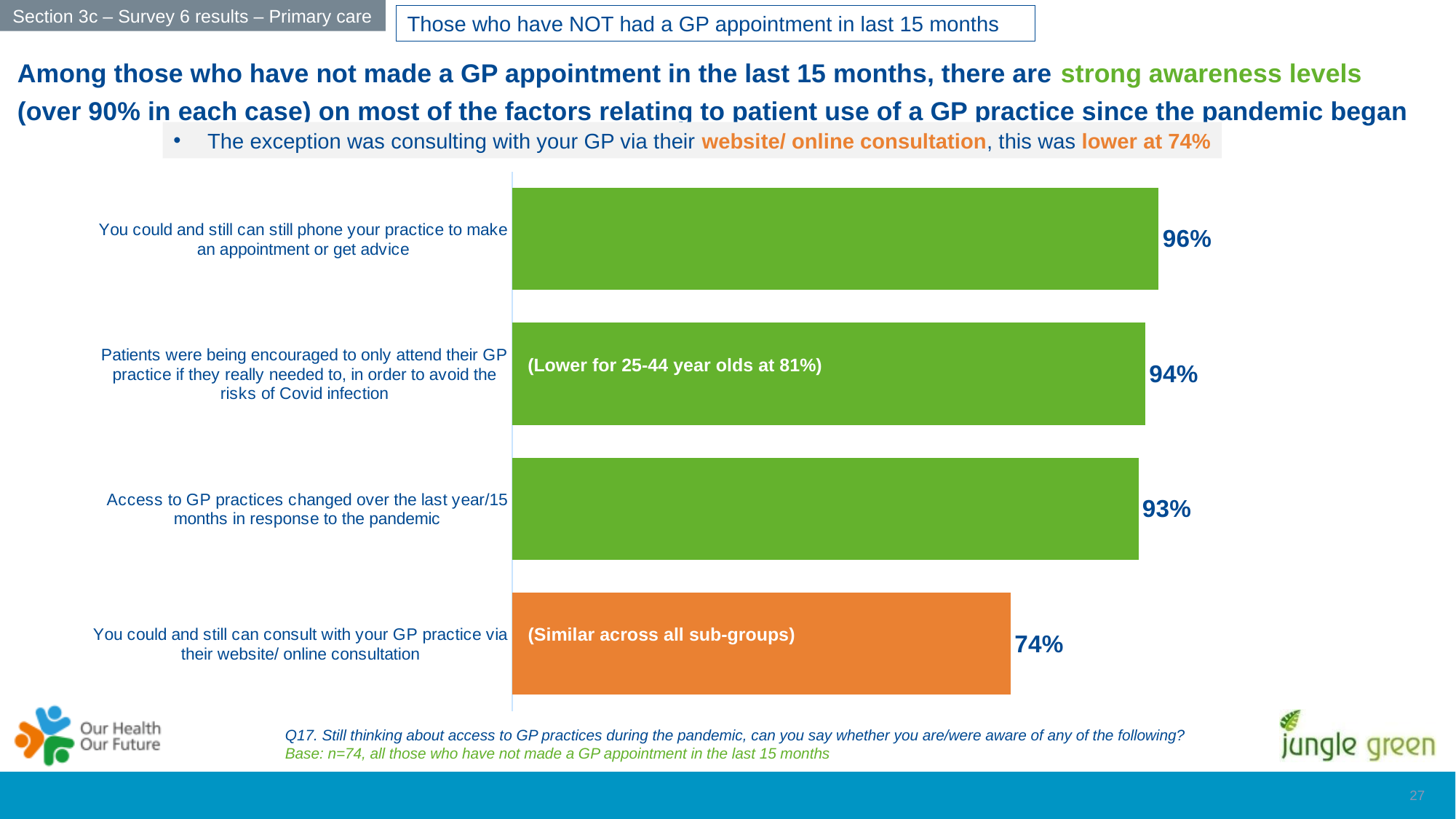
What percentage were aware that you could and still can phone your practice to make an appointment or get advice? 96% Which factor has the lowest awareness level? You could and still can consult with your GP practice via their website/ online consultation What percentage were aware that you could and still can consult with your GP practice via their website/ online consultation? 74% What is the difference in percentage points between awareness of phoning the practice and awareness of consulting via the website/ online consultation? 22 percentage points What percentage were aware that access to GP practices changed over the last year/15 months in response to the pandemic? 93% Which factor has the highest awareness level? You could and still can still phone your practice to make an appointment or get advice Which bar is coloured orange rather than green? You could and still can consult with your GP practice via their website/ online consultation What type of chart is shown on the slide? Bar chart Which is larger: awareness that patients were encouraged to only attend if really needed, or awareness that access to GP practices changed? Patients were being encouraged to only attend their GP practice if they really needed to How many factors are shown in the chart? 4 What is the base size (n) for the chart? n=74 What percentage were aware that patients were being encouraged to only attend their GP practice if they really needed to? 94%